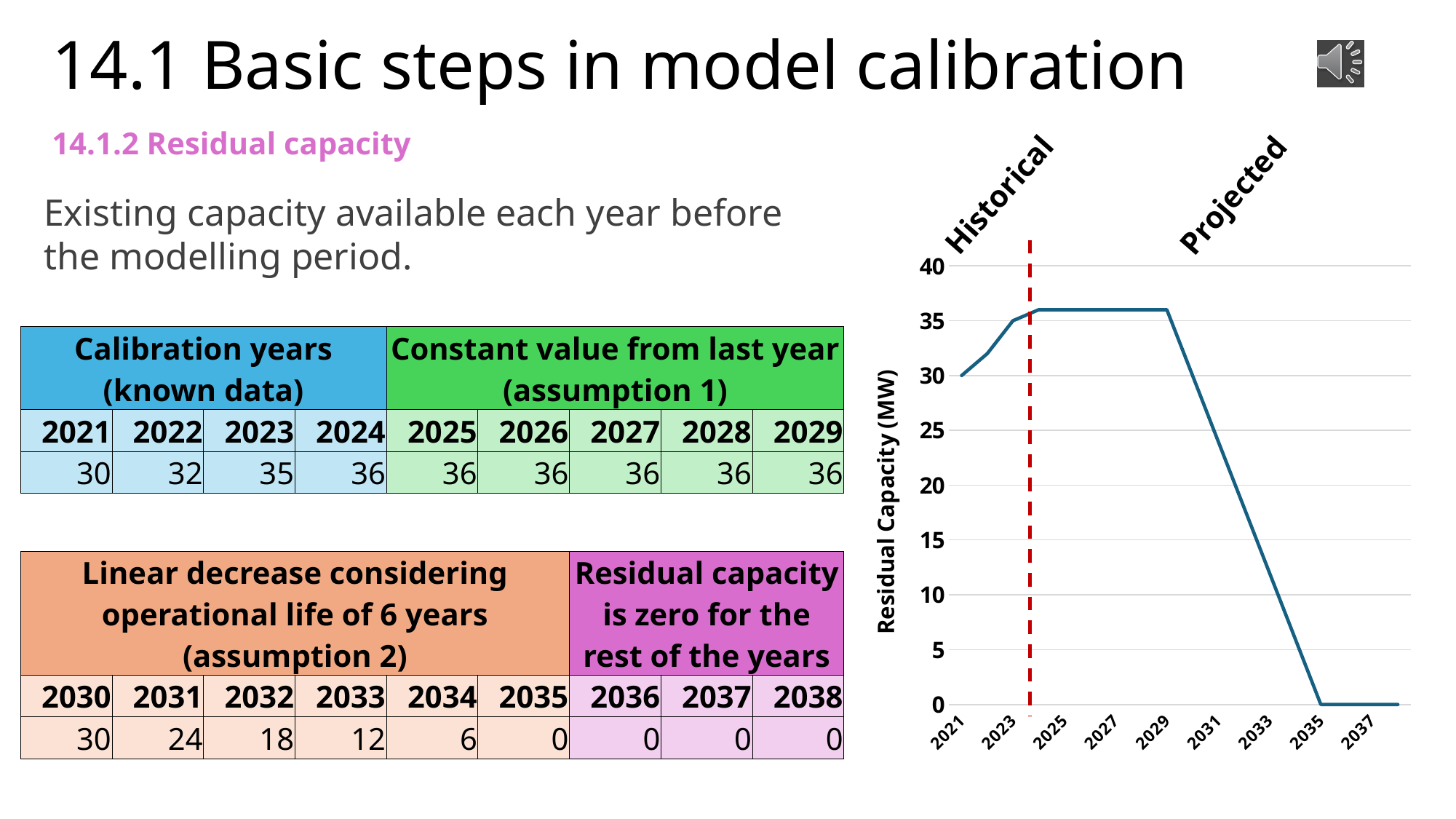
What is the residual capacity plotted for 2037? 0 What is the residual capacity plotted for 2030? 30 What two labels are written above the chart on either side of the dashed vertical line? Historical and Projected Is the value for 2029 greater or less than 35? greater What is the label of the y axis of the chart? Residual Capacity (MW) What type of chart is shown on the right of the slide? line chart What is the residual capacity plotted for 2021? 30 Which year has the larger residual capacity, 2023 or 2031? 2023 Is the value for 2027 greater or less than 35? greater Is the value for 2033 greater or less than 15? less Does the line rise or fall between 2029 and 2035? fall Does the line rise or fall between 2021 and 2024? rise